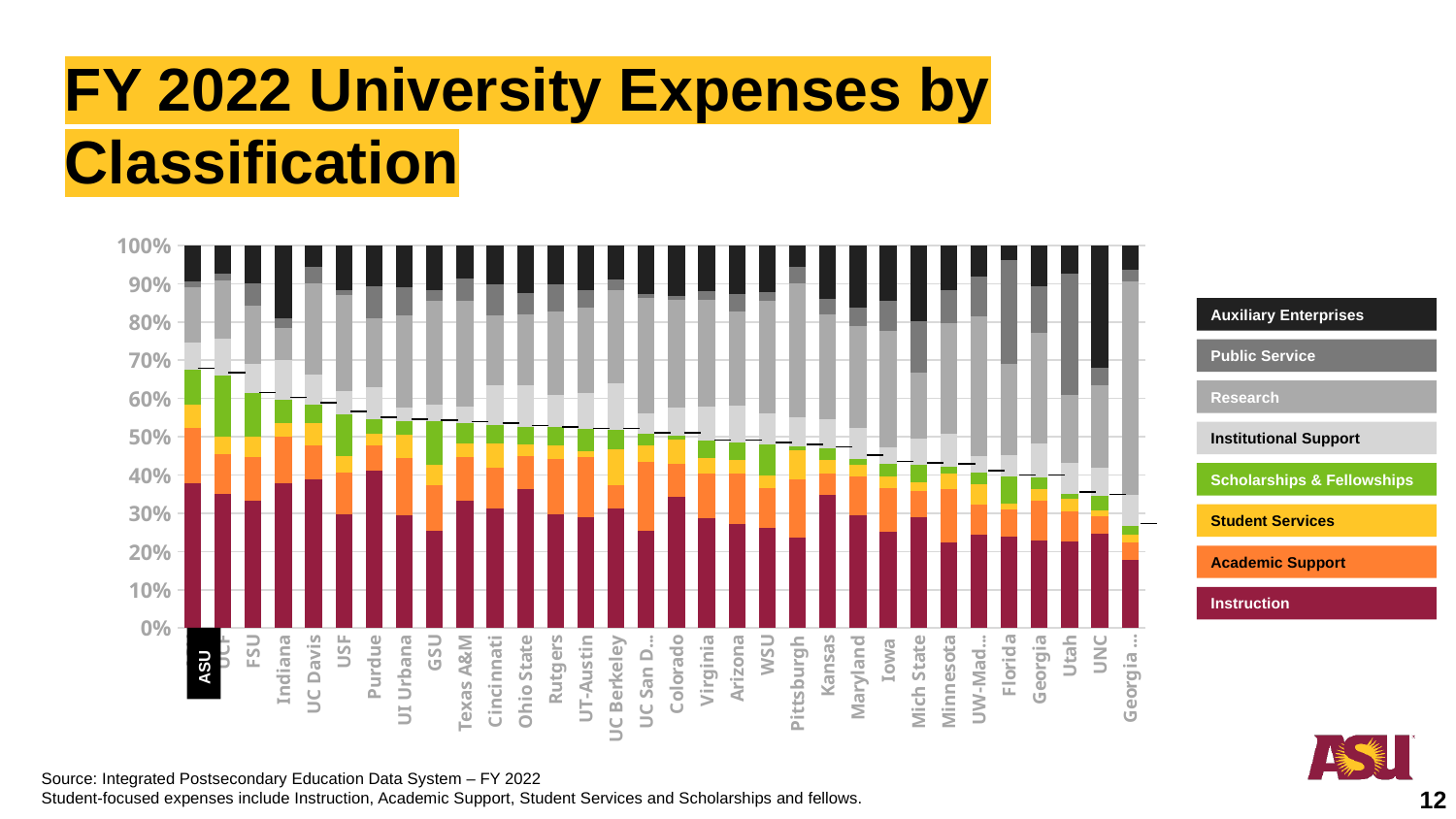
Which university has a larger Instruction share, Purdue or Georgia (the last bar)? Purdue Which university has a larger Instruction share, ASU or GSU? ASU Which university is listed first (leftmost) on the x axis? ASU Which expense classification is shown in the maroon (dark red) segment at the bottom of each bar? Instruction Is the Instruction share for ASU greater or less than 30%? greater Is the Auxiliary Enterprises share for Florida greater or less than 10%? less Is the Auxiliary Enterprises share for UNC greater or less than 20%? greater What is the title of the slide's chart? FY 2022 University Expenses by Classification How many expense classifications does the legend list? 8 Does the combined student-focused share (marked by the black line on each bar) rise or fall moving from left to right across the universities? fall What kind of chart is shown on the slide? Stacked bar chart